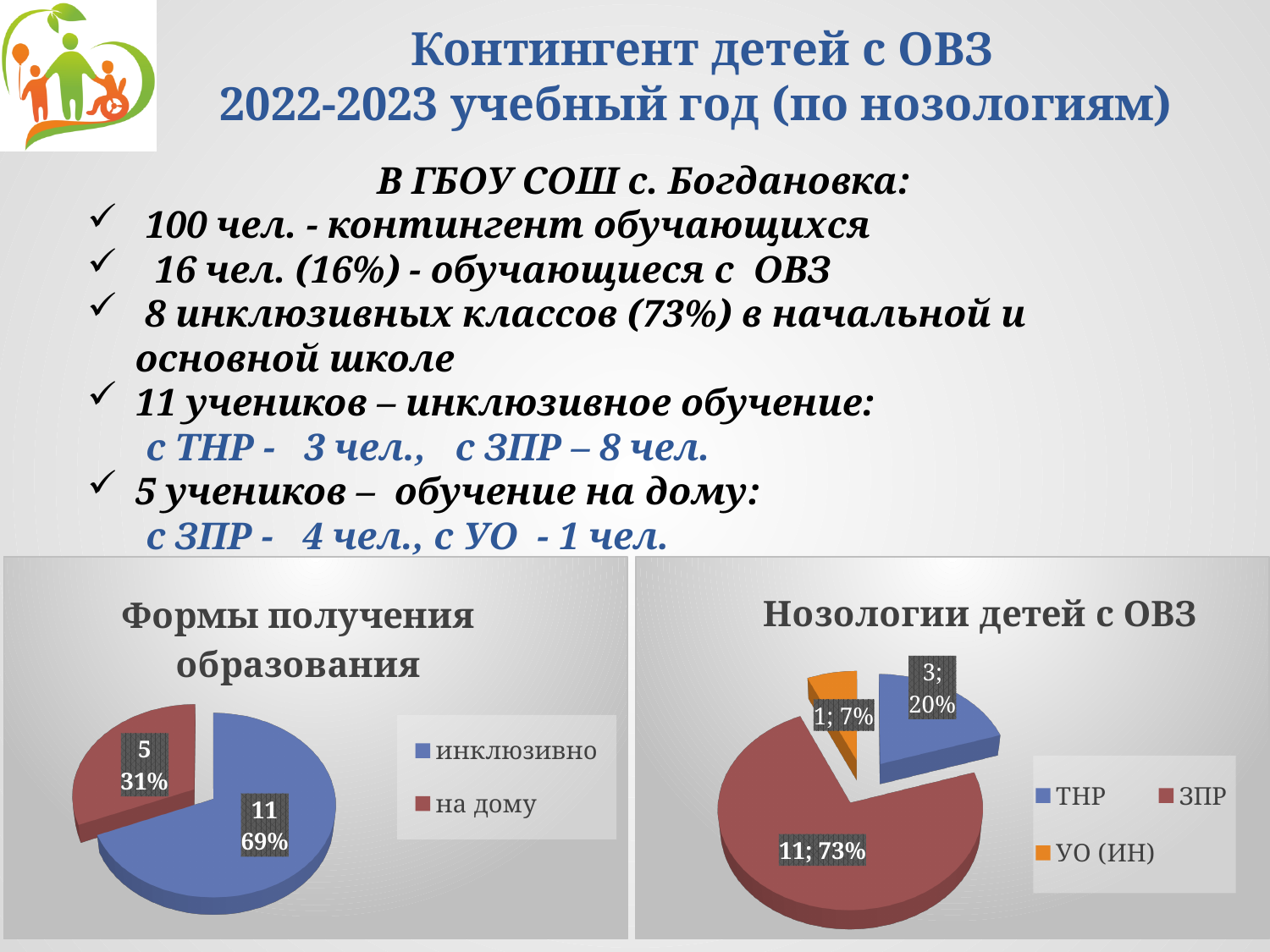
In the chart titled "Нозологии детей с ОВЗ", how many categories are shown? 3 In the chart titled "Нозологии детей с ОВЗ", which category has the smallest value? УО (ИН) In the chart titled "Нозологии детей с ОВЗ", which is larger, the value for "ТНР" or the value for "УО (ИН)"? ТНР In the chart titled "Формы получения образования", which category has the larger value? инклюзивно In the chart titled "Формы получения образования", what kind of chart is shown? pie chart In the chart titled "Формы получения образования", how many entries does the legend list? 2 In the chart titled "Нозологии детей с ОВЗ", how many children are in the "ЗПР" slice? 11 In the chart titled "Нозологии детей с ОВЗ", what percentage share does the "ТНР" slice have? 20% In the chart titled "Формы получения образования", what is the difference between the "инклюзивно" and "на дому" values? 6 In the chart titled "Нозологии детей с ОВЗ", what colour is the "ЗПР" slice? red In the chart titled "Формы получения образования", how many students are in the "инклюзивно" slice? 11 In the chart titled "Формы получения образования", what percentage share does the "на дому" slice have? 31%